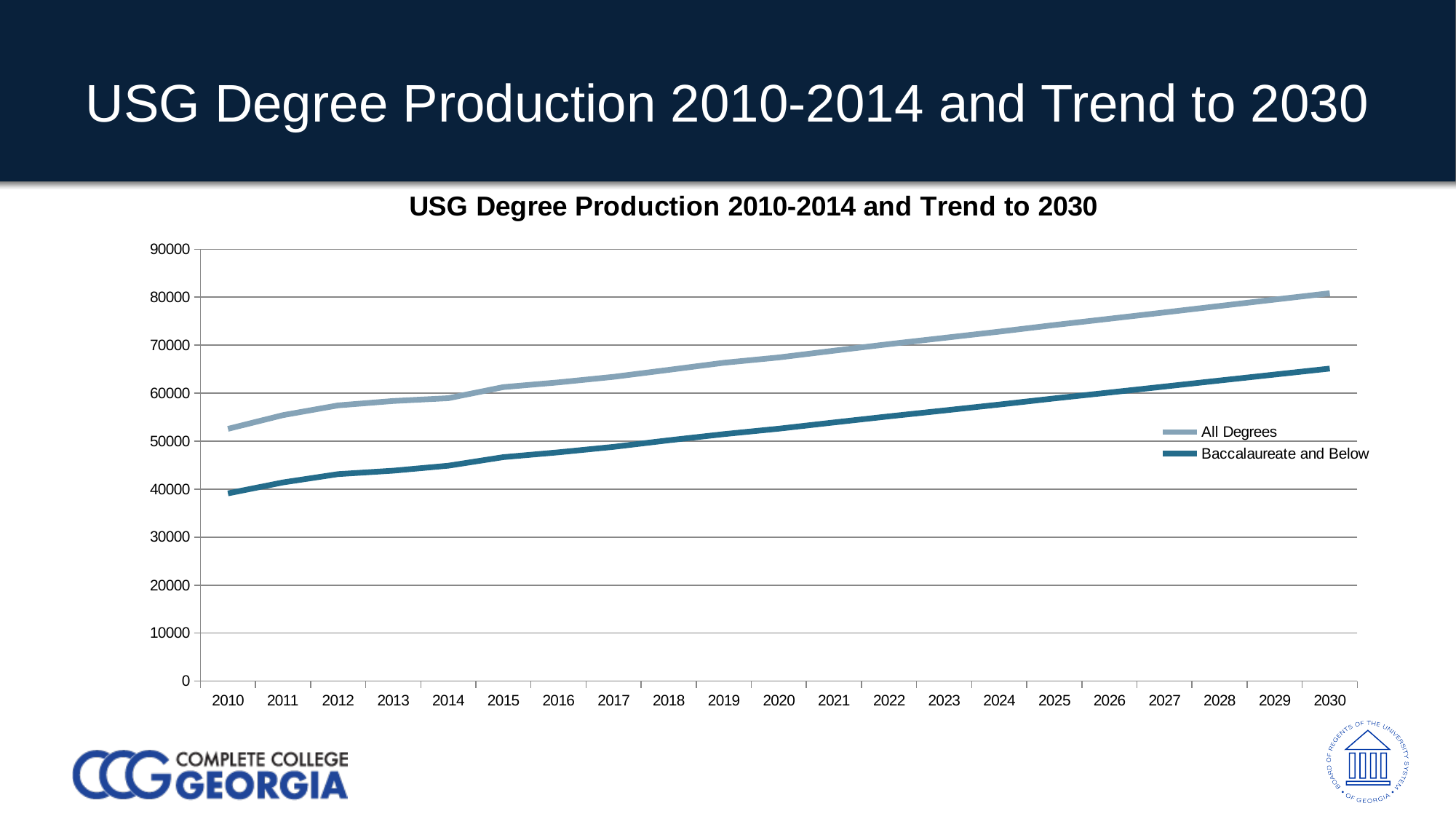
What kind of chart is shown on the slide? line chart Is the value for All Degrees in 2010 greater or less than 50000? greater Do the values for All Degrees rise or fall from 2010 to 2030? rise What is the title of the chart? USG Degree Production 2010-2014 and Trend to 2030 How many years are plotted along the x axis? 21 In which year is the value for Baccalaureate and Below highest? 2030 Is the value for Baccalaureate and Below in 2030 greater or less than 60000? greater How many series does the legend list? 2 In 2020, which series has the larger value, All Degrees or Baccalaureate and Below? All Degrees